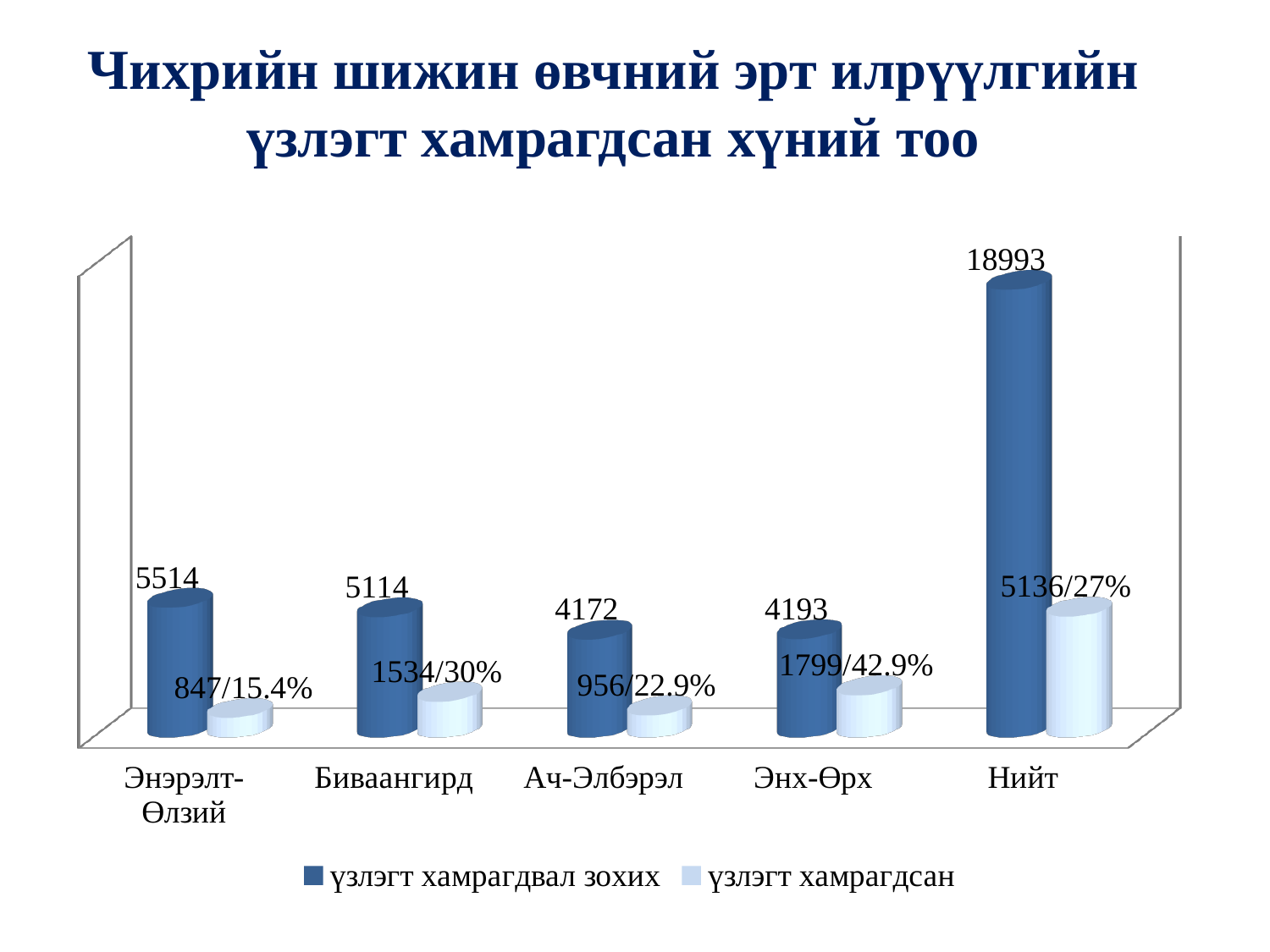
Which category has the highest value in the series "үзлэгт хамрагдвал зохих"? Нийт What is the data label for Энх-Өрх in the series "үзлэгт хамрагдсан"? 1799/42.9% Which is larger in the series "үзлэгт хамрагдсан": Биваангирд or Ач-Элбэрэл? Биваангирд What kind of chart is shown on the slide? Bar chart Excluding Нийт, which category has the lowest value in the series "үзлэгт хамрагдсан"? Энэрэлт-Өлзий How many series does the legend list? 2 What is the value for Ач-Элбэрэл in the series "үзлэгт хамрагдвал зохих"? 4172 How many categories are shown on the x axis? 5 What is the value for Энэрэлт-Өлзий in the series "үзлэгт хамрагдвал зохих"? 5514 What is the difference between the "үзлэгт хамрагдвал зохих" values for Энэрэлт-Өлзий and Биваангирд? 400 What is the data label for Нийт in the series "үзлэгт хамрагдсан"? 5136/27% Which series is shown in dark blue according to the legend? үзлэгт хамрагдвал зохих